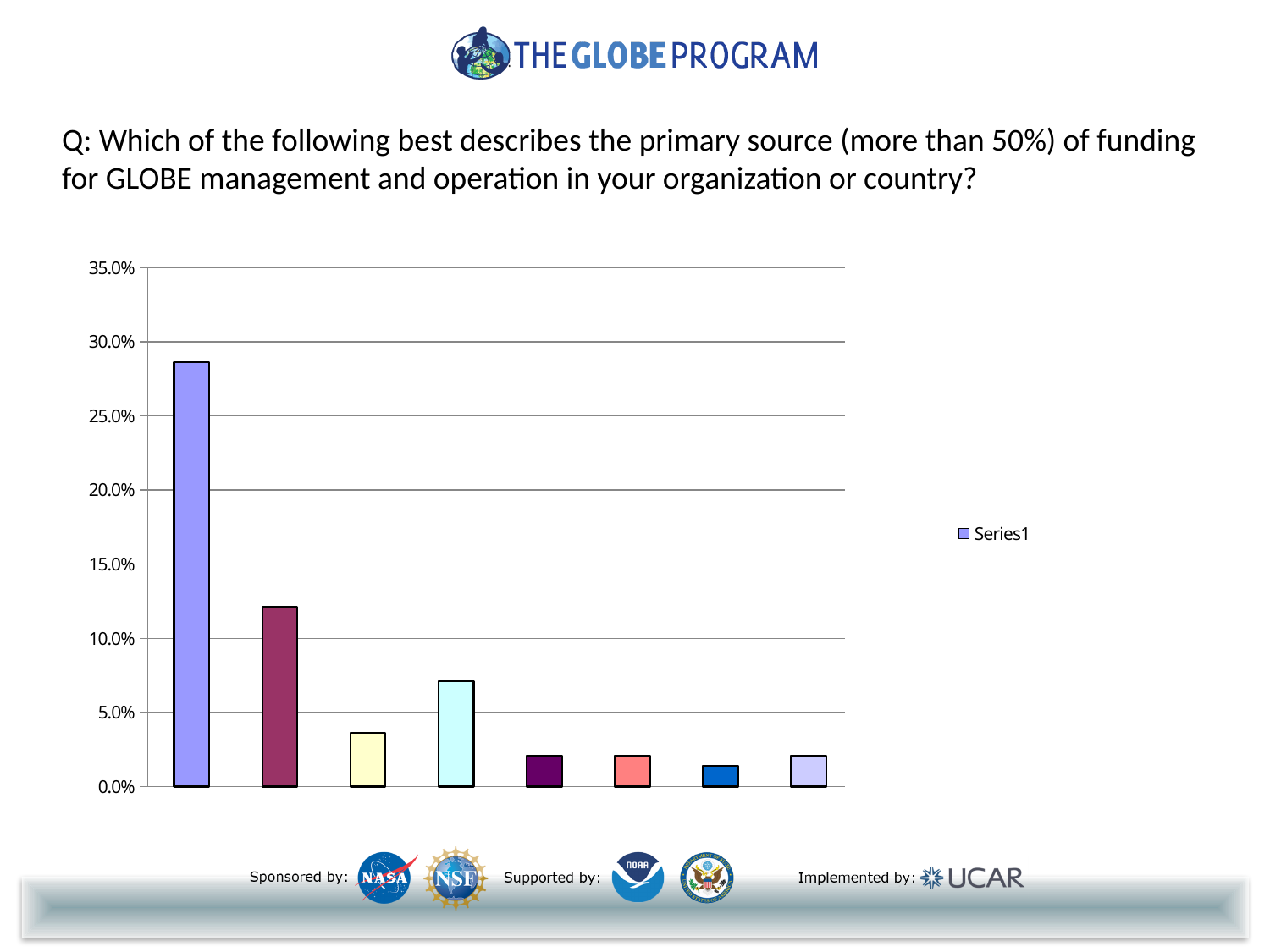
Is the value of the third bar from the left greater or less than 5.0%? less How many series does the legend list? 1 What is the name of the series shown in the legend? Series1 Which bar is the tallest in the chart? the first (leftmost) bar What kind of chart is shown on the slide? bar chart Which is larger, the second bar from the left or the fourth bar from the left? the second bar from the left How many bars are plotted in the chart? 8 Is the value of the first (leftmost) bar greater or less than 25.0%? greater What is the highest value shown on the vertical axis? 35.0% Is the value of the fourth bar from the left greater or less than 5.0%? greater